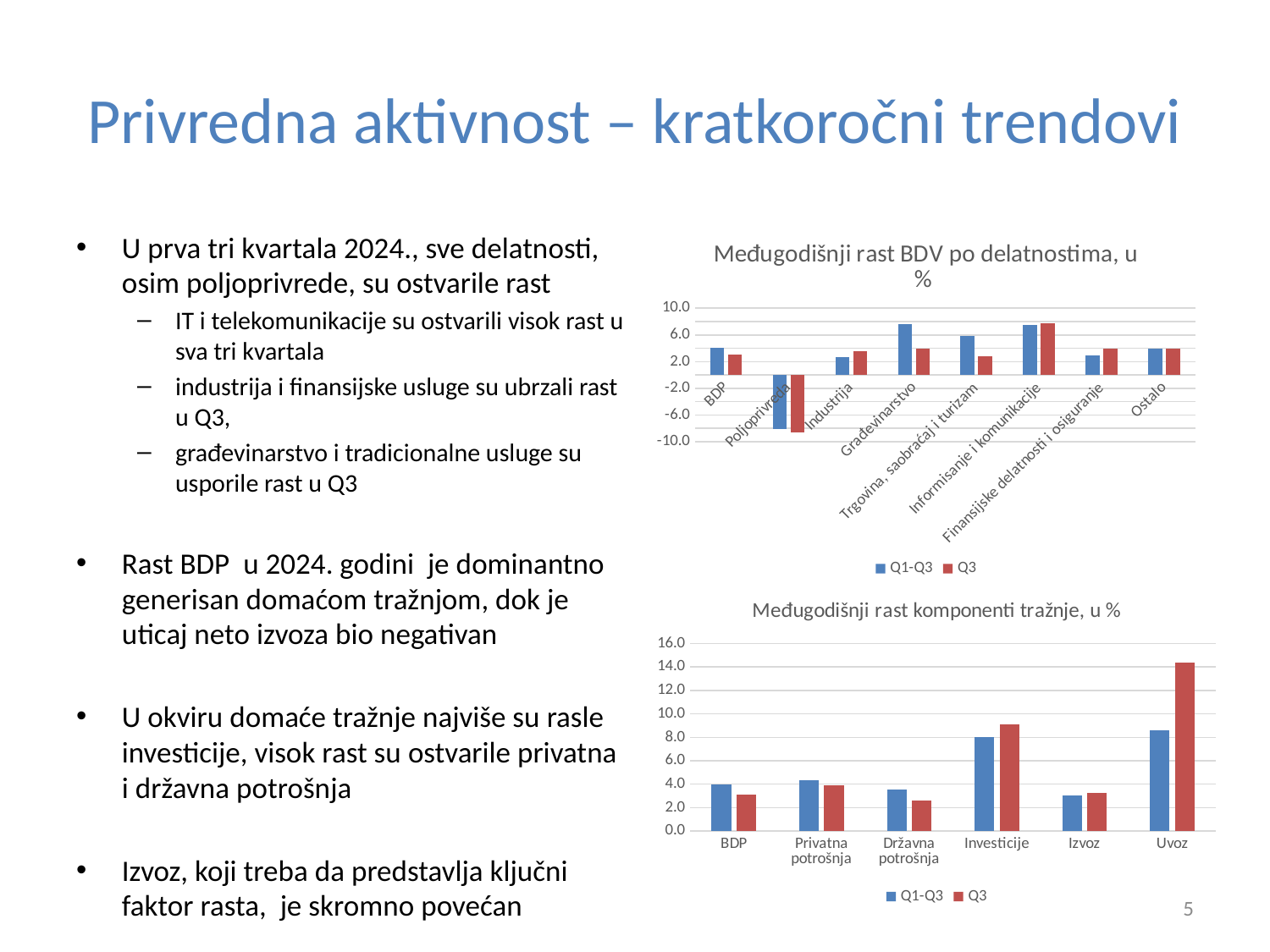
How many series does the legend of the chart titled "Međugodišnji rast BDV po delatnostima, u %" list? 2 What type of chart is the chart titled "Međugodišnji rast komponenti tražnje, u %"? bar chart In the chart titled "Međugodišnji rast komponenti tražnje, u %", which category has the highest Q3 value? Uvoz In the chart titled "Međugodišnji rast komponenti tražnje, u %", is the Q1-Q3 value for Investicije greater or less than 6.0? greater In the chart titled "Međugodišnji rast komponenti tražnje, u %", which is larger for Uvoz: the Q1-Q3 value or the Q3 value? Q3 In the chart titled "Međugodišnji rast BDV po delatnostima, u %", which has the larger Q1-Q3 value: Industrija or Informisanje i komunikacije? Informisanje i komunikacije In the chart titled "Međugodišnji rast komponenti tražnje, u %", is the Q3 value for Uvoz greater or less than 12.0? greater What are the two legend entries of the chart titled "Međugodišnji rast komponenti tražnje, u %"? Q1-Q3 and Q3 In the chart titled "Međugodišnji rast BDV po delatnostima, u %", is the Q3 value for Poljoprivreda greater or less than -6.0? less In the chart titled "Međugodišnji rast BDV po delatnostima, u %", which category has the lowest Q1-Q3 value? Poljoprivreda How many categories are shown on the x axis of the chart titled "Međugodišnji rast BDV po delatnostima, u %"? 8 How many categories are shown on the x axis of the chart titled "Međugodišnji rast komponenti tražnje, u %"? 6